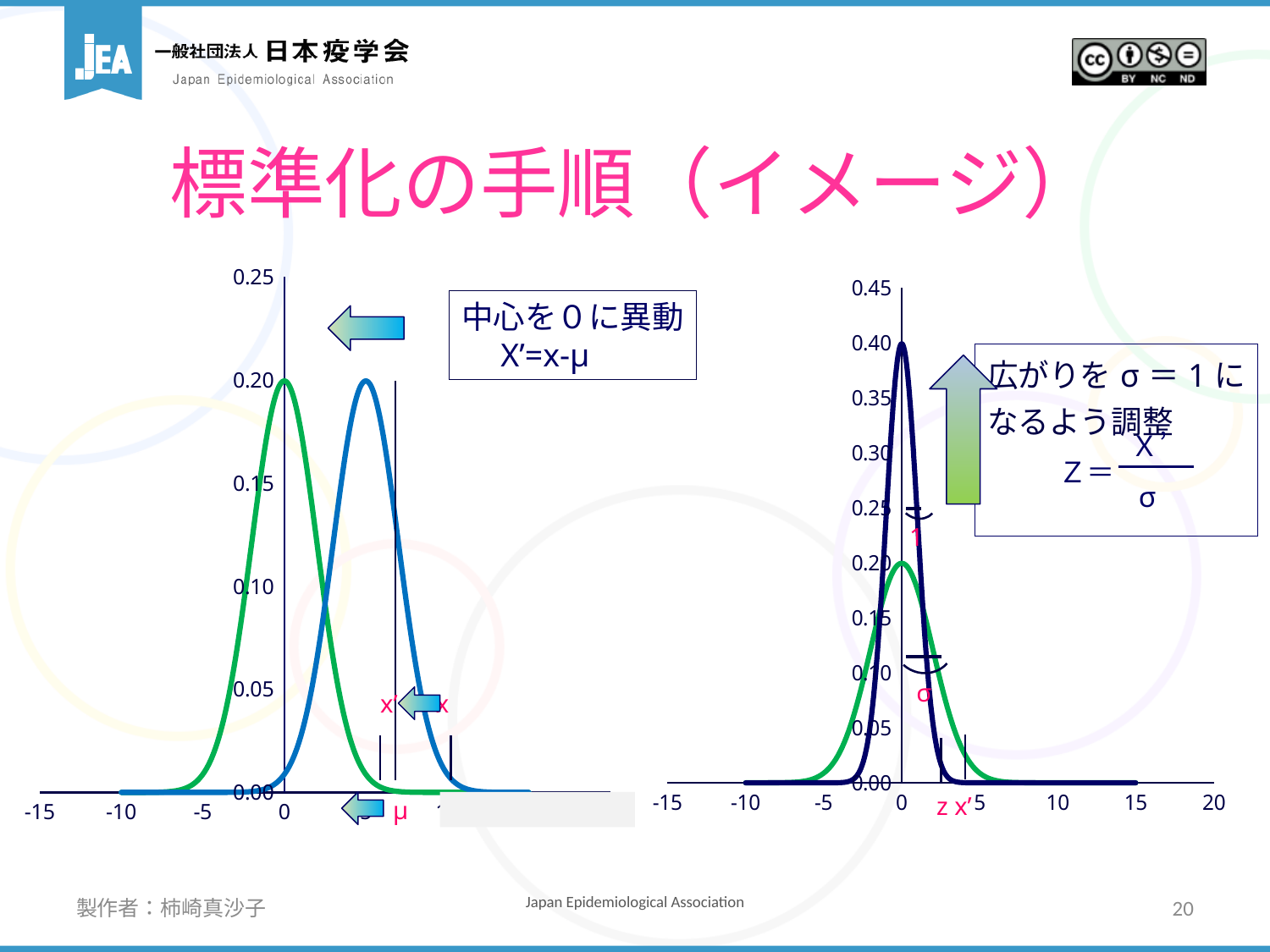
What kind of chart is the left chart on the slide? line chart On the right chart, is the peak of the green curve greater or less than 0.30? less How many curves are plotted on the right chart? 2 What kind of chart is the right chart on the slide? line chart On the right chart, does the dark navy curve rise or fall as x goes from 0 to 5? fall How many curves are plotted on the left chart? 2 On the right chart, which curve has the higher peak, the green one or the dark navy one? the dark navy one On the left chart, is the peak of the green curve greater or less than 0.10? greater On the left chart, which curve is centered further to the right, the green one or the blue one? the blue one On the right chart, is the peak of the dark navy curve greater or less than 0.30? greater What is the highest value shown on the y axis of the left chart? 0.25 What is the highest value shown on the y axis of the right chart? 0.45